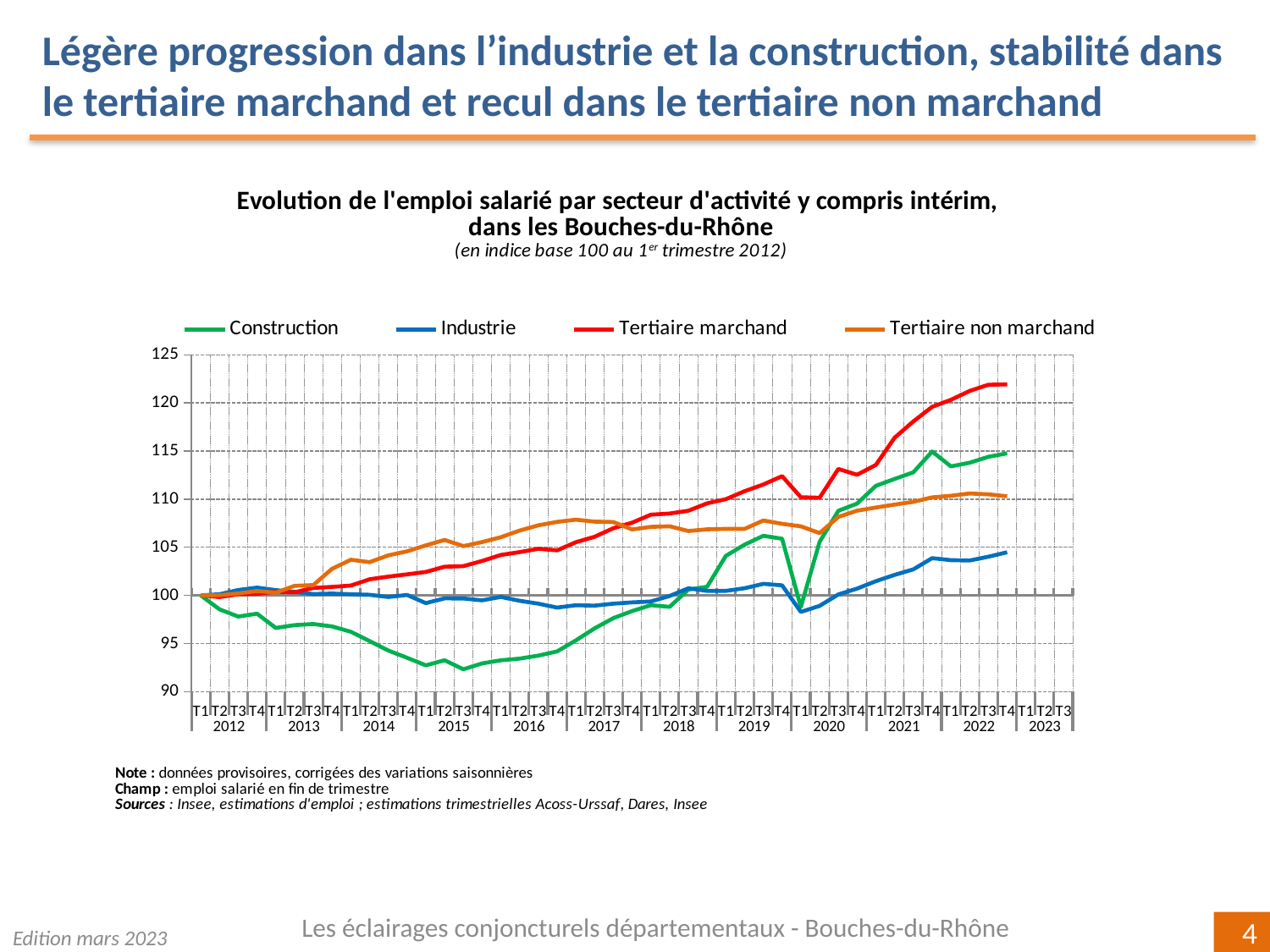
Which series has the lowest value at T4 2022? Industrie Which series is shown in red in the legend? Tertiaire marchand Is the value for Construction at T1 2015 greater or less than 95? less Is the value for Tertiaire marchand at T4 2022 greater or less than 120? greater At T4 2022, which is larger: the value for Construction or the value for Industrie? Construction Which series has the highest value at T4 2022? Tertiaire marchand How many series does the legend list? 4 Is the value for Industrie at T4 2022 greater or less than 100? greater What kind of chart is shown on the slide? line chart Does the Tertiaire marchand series generally rise or fall from 2012 to 2022? rise What is the index value of all series at T1 2012, the base quarter? 100 Which series has the lowest value at T1 2015? Construction